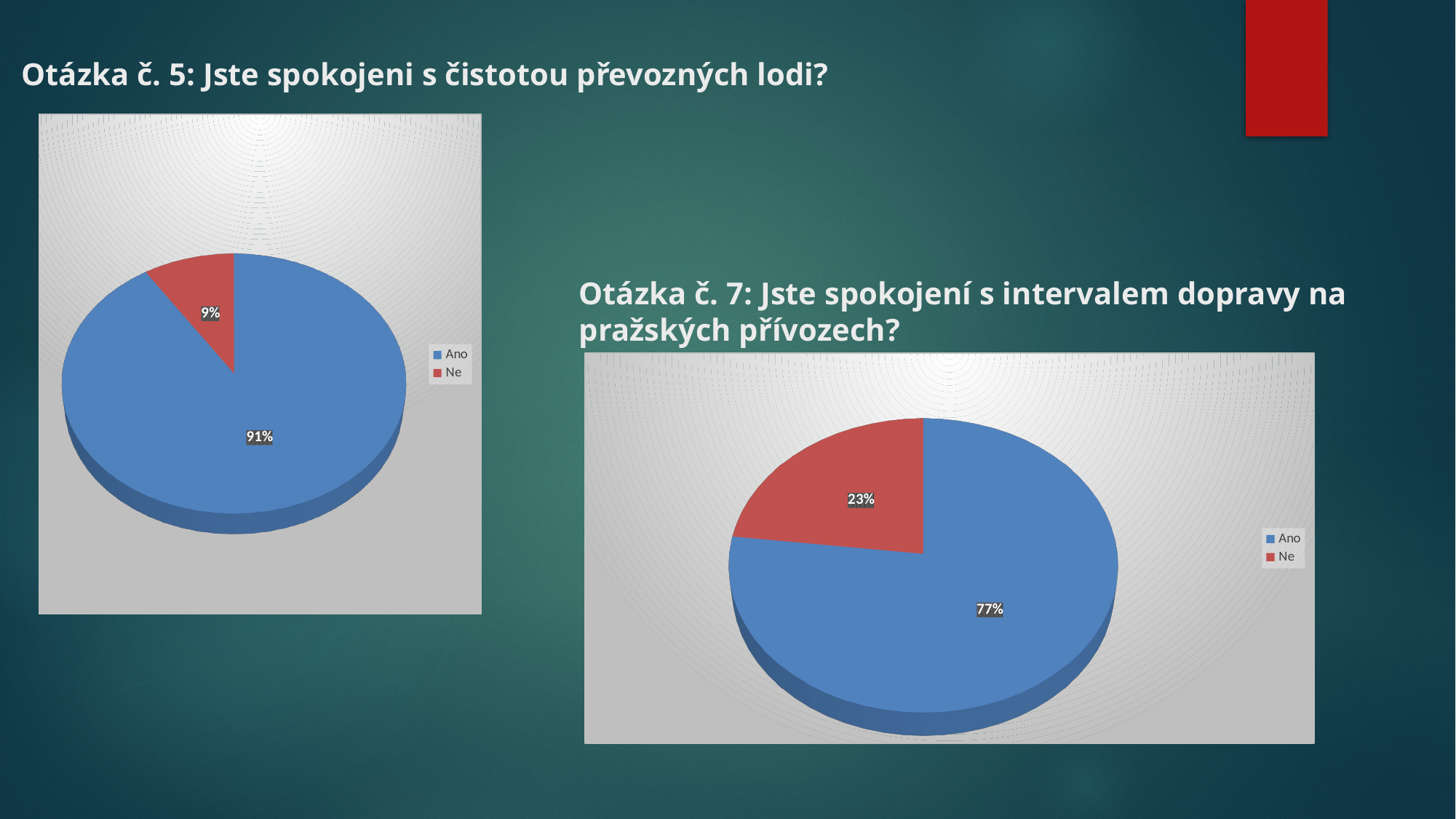
In the right chart (Otázka č. 7), what share of the pie is labelled "Ne"? 23% In the right chart (Otázka č. 7), what share of the pie is labelled "Ano"? 77% In the left chart (Otázka č. 5), what share of the pie is labelled "Ne"? 9% In the right chart (Otázka č. 7), which category has the smallest slice? Ne In the left chart (Otázka č. 5), which category has the largest slice? Ano How many categories does the legend of the left chart (Otázka č. 5) list? 2 In the right chart (Otázka č. 7), what colour is the "Ne" slice? Red In the left chart (Otázka č. 5), what is the difference between the "Ano" and "Ne" shares? 82% What kind of chart is used for Otázka č. 7? Pie chart Is the "Ne" share larger in the left chart (Otázka č. 5) or the right chart (Otázka č. 7)? Right chart (Otázka č. 7) In the right chart (Otázka č. 7), what is the difference between the "Ano" and "Ne" shares? 54%